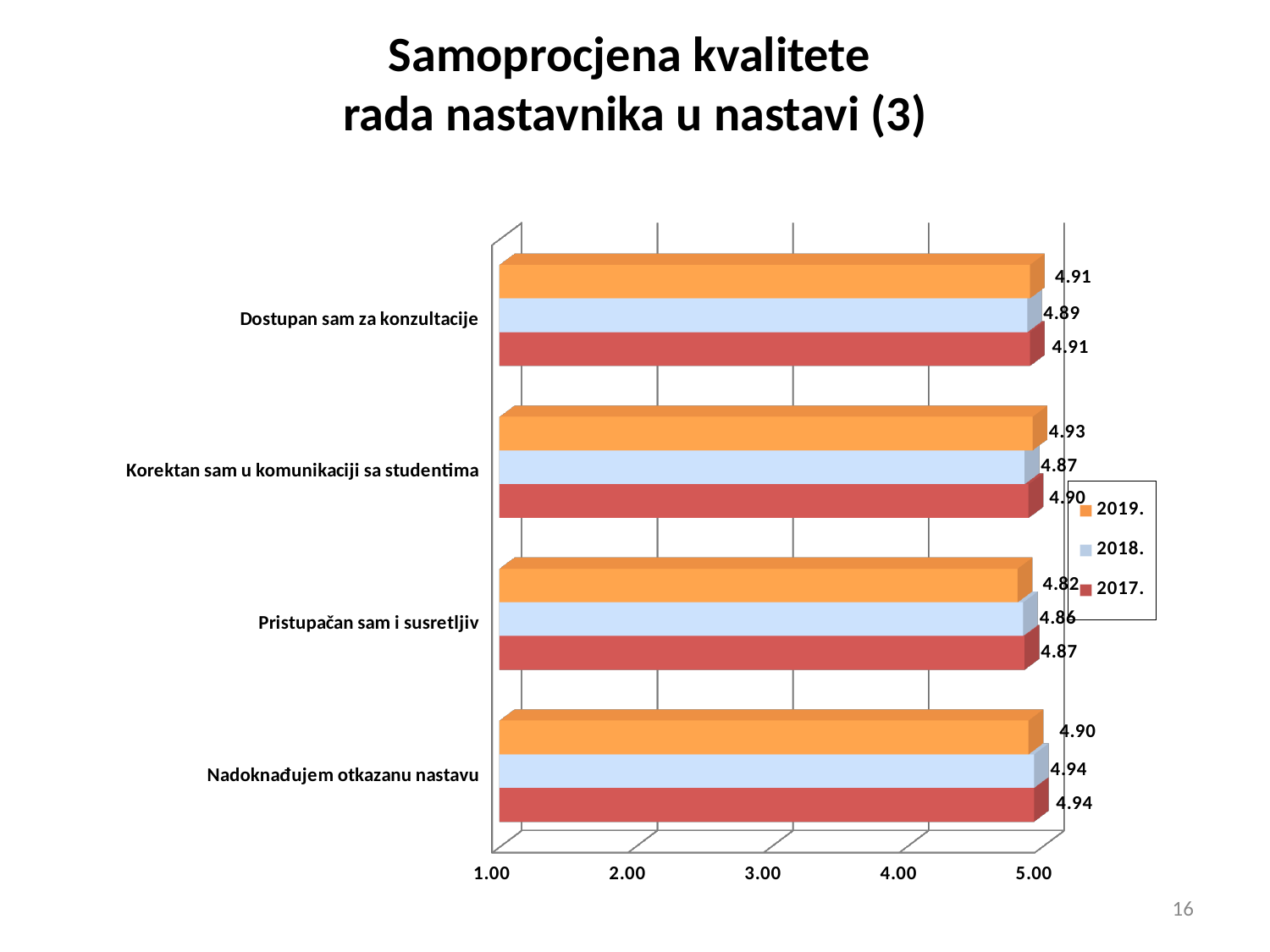
What is the 2019. value for "Dostupan sam za konzultacije"? 4.91 What is the difference between the 2019. and 2018. values for "Korektan sam u komunikaciji sa studentima"? 0.06 What is the 2018. value for "Nadoknađujem otkazanu nastavu"? 4.94 What is the 2018. value for "Korektan sam u komunikaciji sa studentima"? 4.87 How many categories are shown on the chart? 4 How many series does the legend list? 3 Which series is shown in orange? 2019. What kind of chart is shown on the slide? Bar chart For "Pristupačan sam i susretljiv", which is larger: the 2019. value or the 2017. value? 2017. Which category has the highest 2019. value? Korektan sam u komunikaciji sa studentima Which category has the lowest 2019. value? Pristupačan sam i susretljiv What is the 2017. value for "Pristupačan sam i susretljiv"? 4.87